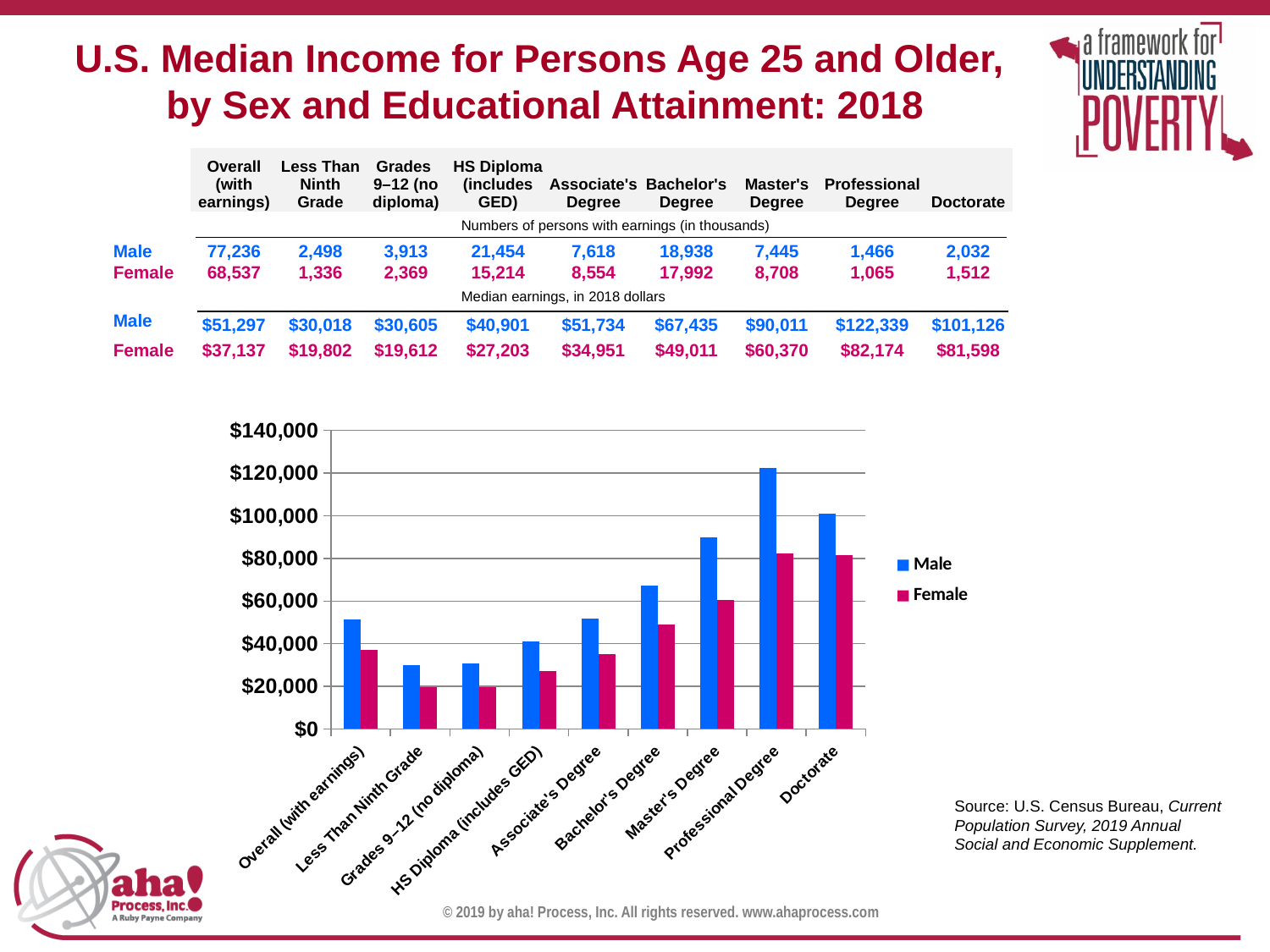
Which is larger: Male median earnings for Bachelor's Degree or Female median earnings for Master's Degree? Male Bachelor's Degree Is the Female value for Associate's Degree greater or less than $40,000? less How many educational attainment categories are plotted along the x axis of the chart? 9 What kind of chart is shown on the slide? Bar chart Which category has the highest Male median earnings in the chart? Professional Degree What is the difference between Male and Female median earnings for Doctorate? $19,528 What is the Male median earnings value for Master's Degree? $90,011 How many series does the chart's legend list? 2 What is the difference between Male median earnings for Professional Degree and for Doctorate? $21,213 Which colour represents the Female series in the chart? Magenta (pink) Do the Male median earnings rise or fall from Associate's Degree through Professional Degree? Rise What is the Female median earnings value for Bachelor's Degree? $49,011